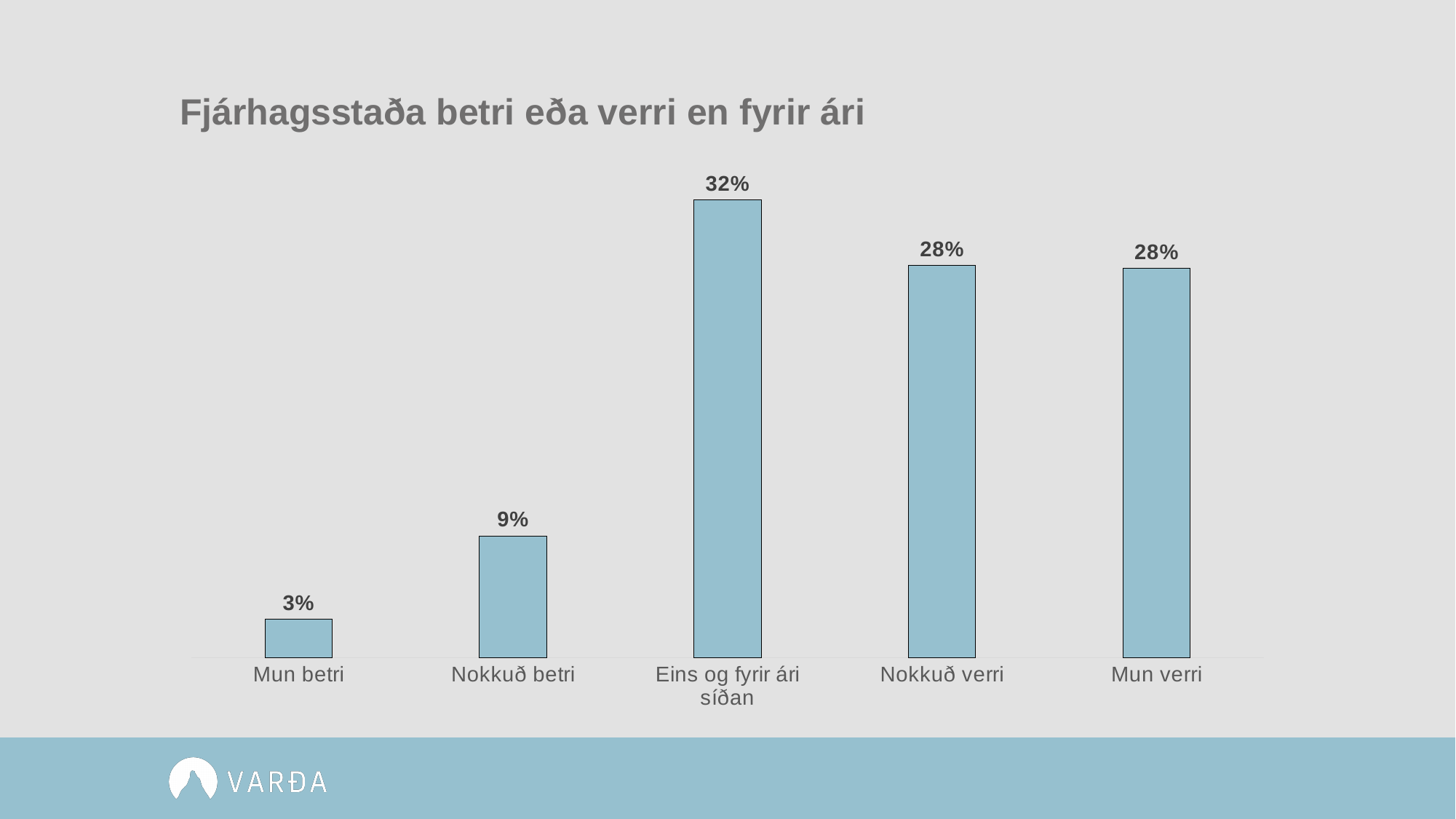
How many categories are shown in the chart? 5 Which is larger, the value for "Nokkuð betri" or the value for "Mun verri"? Mun verri What type of chart is shown on the slide? Bar chart Which category has the highest value? Eins og fyrir ári síðan What is the value for "Mun verri"? 28% What is the difference between the values for "Eins og fyrir ári síðan" and "Nokkuð verri"? 4% What is the difference between the values for "Nokkuð betri" and "Mun betri"? 6% What is the value for "Mun betri"? 3% What is the value for "Nokkuð verri"? 28% Which category has the lowest value? Mun betri What is the value for "Nokkuð betri"? 9% What is the value for "Eins og fyrir ári síðan"? 32%